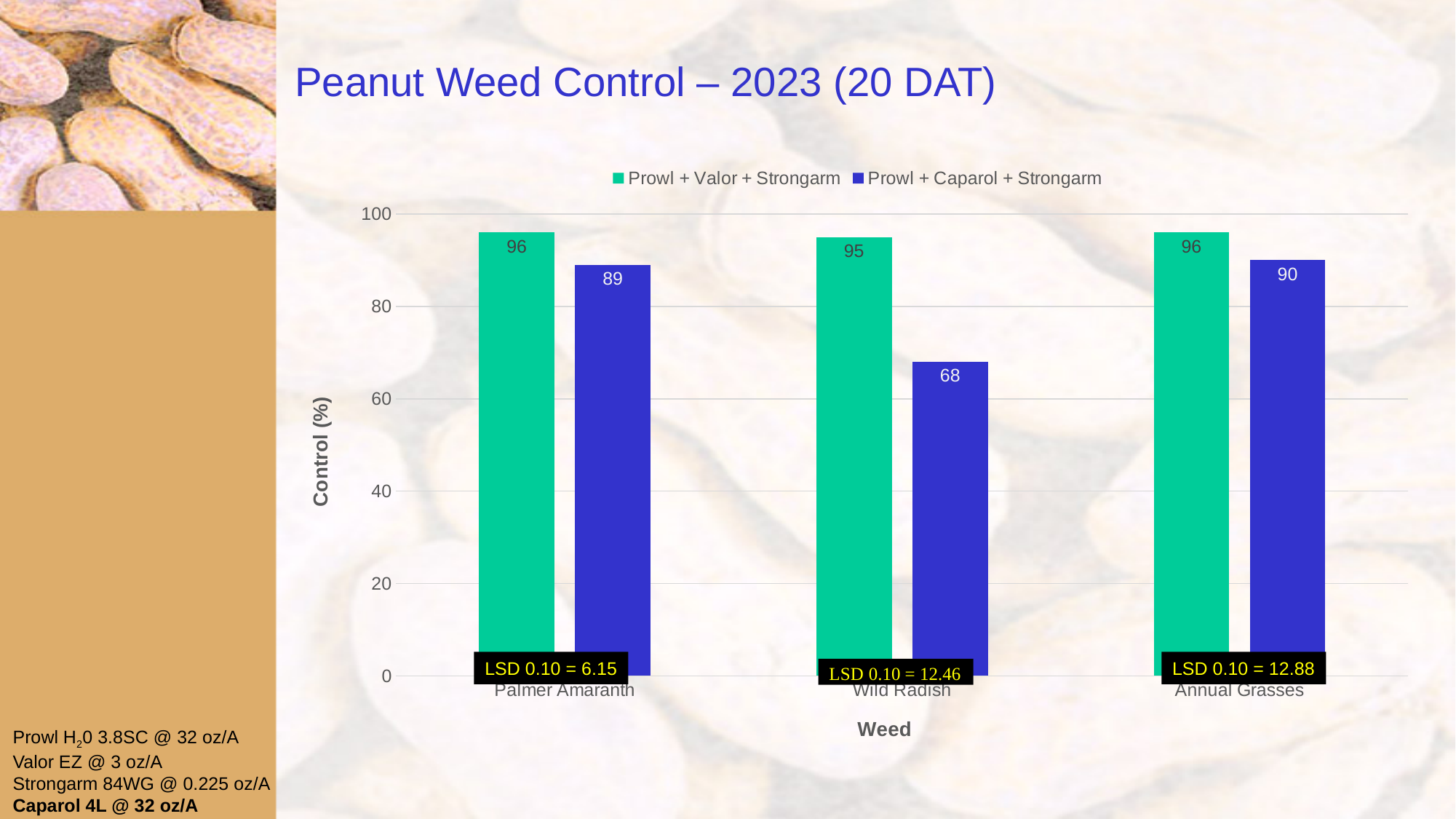
What is the difference between the two series' values for Palmer Amaranth? 7 What is the value for Prowl + Caparol + Strongarm on Wild Radish? 68 For which weed is the Prowl + Caparol + Strongarm value lowest? Wild Radish What is the value for Prowl + Valor + Strongarm on Wild Radish? 95 How many series does the legend list? 2 What is the title of the y axis? Control (%) How many weed categories are shown on the x axis? 3 What is the difference between the two series' values for Wild Radish? 27 Which series has the larger value for Annual Grasses? Prowl + Valor + Strongarm What kind of chart is shown on the slide? Bar chart What is the value for Prowl + Caparol + Strongarm on Annual Grasses? 90 What is the value for Prowl + Valor + Strongarm on Palmer Amaranth? 96